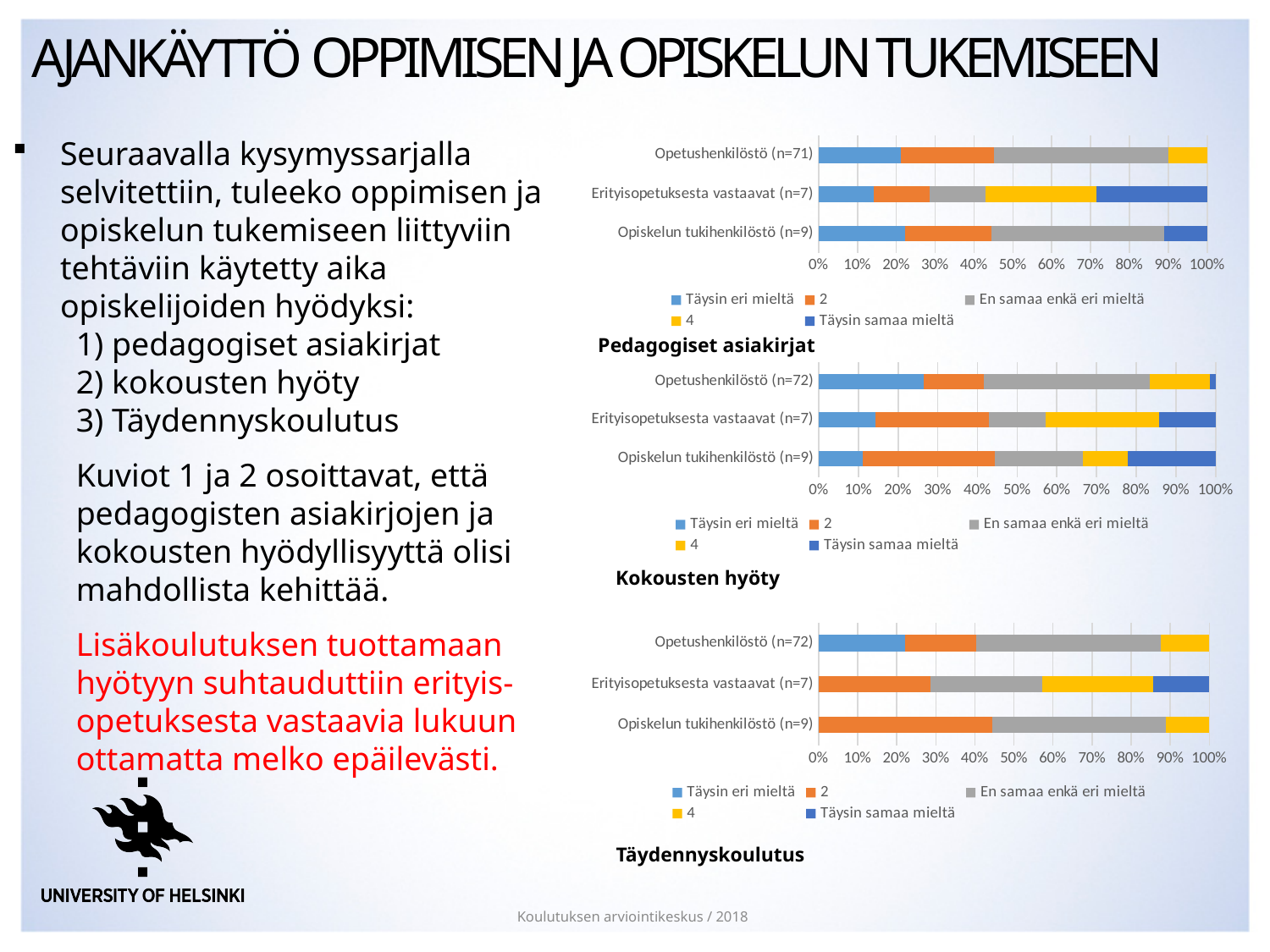
In the 'Täydennyskoulutus' chart, is the 'Täysin eri mieltä' share for Opetushenkilöstö (n=72) greater or less than 10%? greater In the 'Kokousten hyöty' chart, is the 'Täysin eri mieltä' share for Opetushenkilöstö (n=72) greater or less than 20%? greater In the 'Pedagogiset asiakirjat' chart, is the 'Täysin samaa mieltä' share for Erityisopetuksesta vastaavat (n=7) greater or less than 20%? greater In the 'Täydennyskoulutus' chart, which respondent group has the largest 'Täysin samaa mieltä' share? Erityisopetuksesta vastaavat (n=7) What is the title of the bottom chart on the slide? Täydennyskoulutus In the 'Pedagogiset asiakirjat' chart, what is the label of the series shown in grey? En samaa enkä eri mieltä In the 'Täydennyskoulutus' chart, which respondent group has the largest 'Täysin eri mieltä' share? Opetushenkilöstö (n=72) How many respondent groups (categories) are shown in the 'Täydennyskoulutus' chart? 3 What kind of chart is the 'Pedagogiset asiakirjat' chart? Stacked bar chart How many series does the legend of the 'Kokousten hyöty' chart list? 5